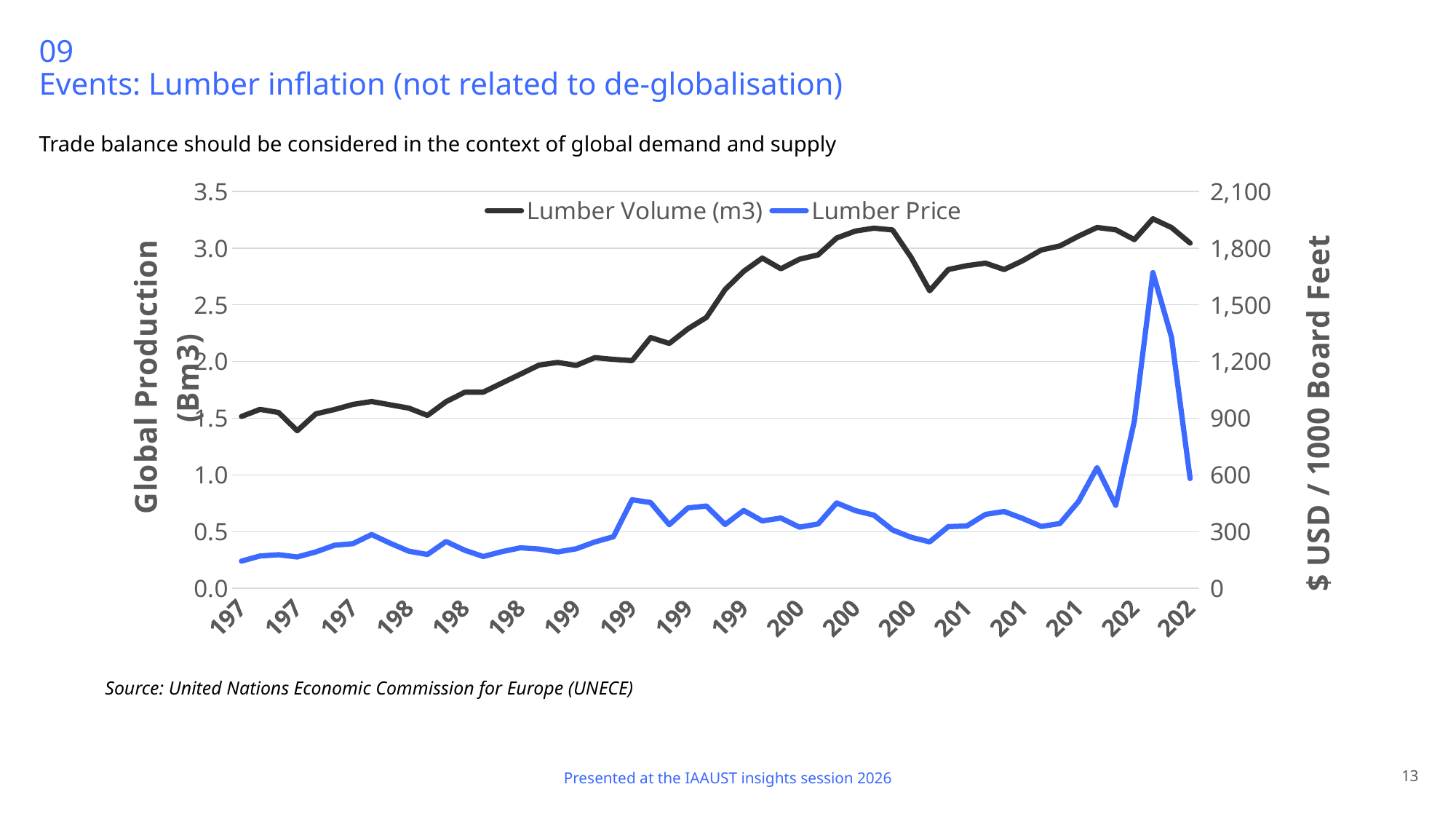
Is the peak value of the Lumber Price series greater or less than 1,500 on the right axis? greater What is the title of the left vertical axis of the chart? Global Production (Bm3) What are the two series named in the chart's legend? Lumber Volume (m3) and Lumber Price What kind of chart is shown on the slide? Line chart Is the highest value of the Lumber Volume (m3) series greater or less than 3.0 on the left axis? greater Is the last (rightmost) value of the Lumber Volume (m3) series greater or less than 2.5 on the left axis? greater How many series does the chart's legend list? 2 Does the Lumber Volume (m3) series generally rise or fall from left to right across the chart? Rise